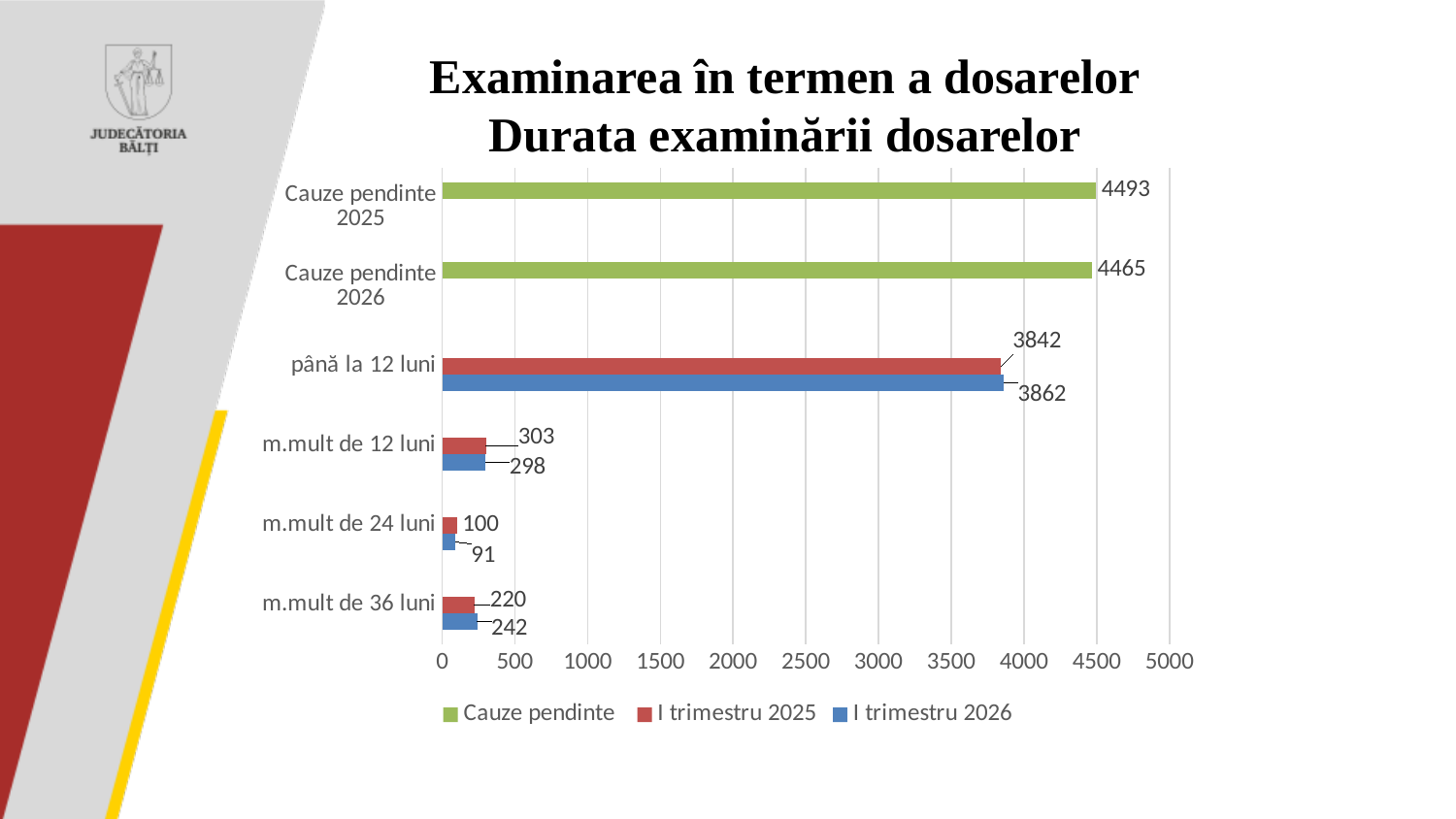
How many series does the legend list? 3 For m.mult de 12 luni, which is larger: the I trimestru 2025 value or the I trimestru 2026 value? I trimestru 2025 What is the difference between Cauze pendinte 2025 and Cauze pendinte 2026? 28 What is the I trimestru 2026 value for m.mult de 24 luni? 91 How many categories are shown on the vertical axis? 6 What is the difference between the I trimestru 2026 and I trimestru 2025 values for până la 12 luni? 20 What is the I trimestru 2026 value for m.mult de 36 luni? 242 What is the value for Cauze pendinte 2025? 4493 Which category has the lowest I trimestru 2025 value? m.mult de 24 luni What kind of chart is shown on the slide? Bar chart What is the I trimestru 2025 value for până la 12 luni? 3842 What is the value for Cauze pendinte 2026? 4465